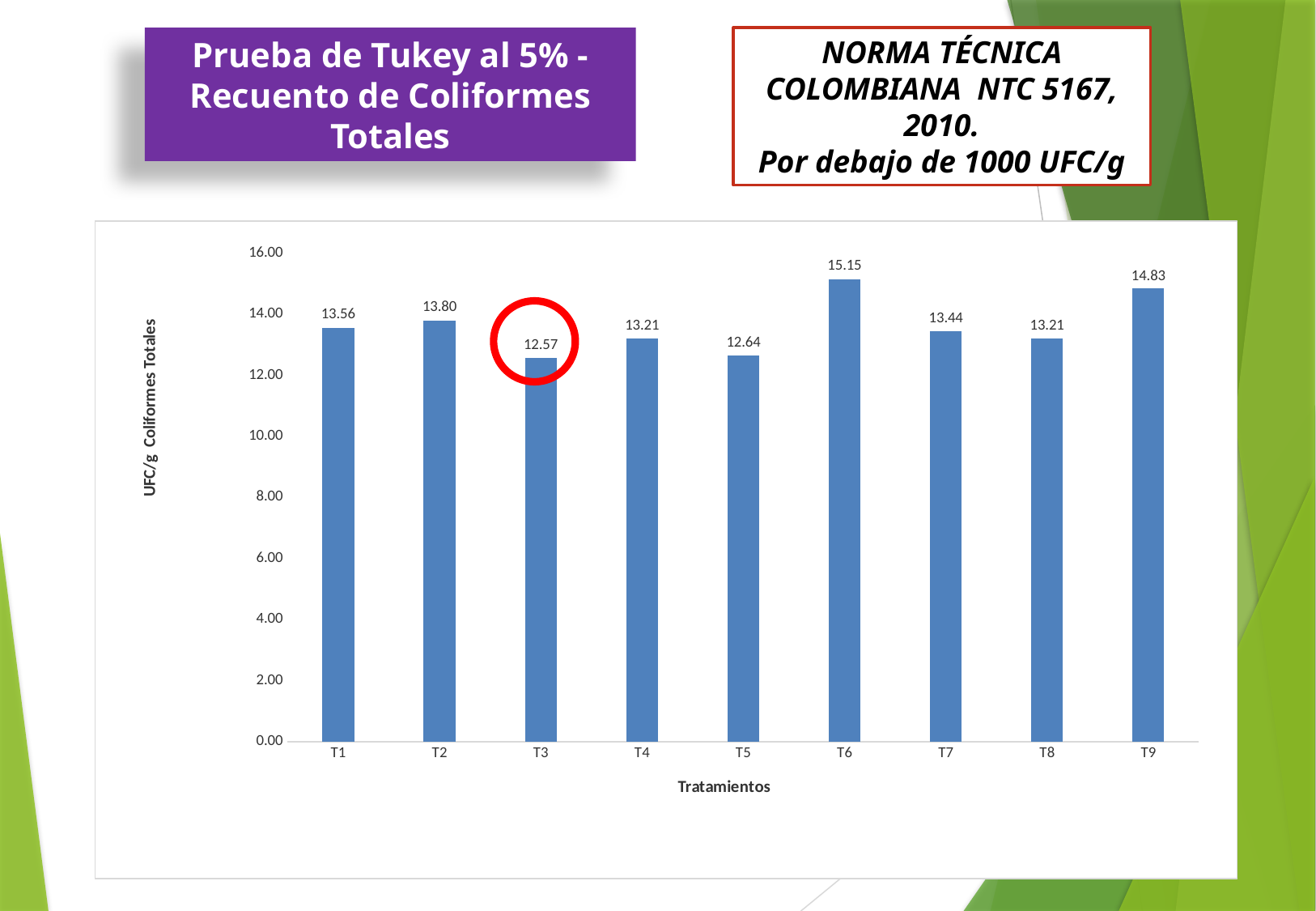
Which treatment has the highest value? T6 Is the value for T5 greater or less than 14.00? less Which bar is circled in red on the chart? T3 What is the label of the y axis? UFC/g Coliformes Totales What is the difference between the values for T6 and T3? 2.58 What is the value for T6? 15.15 Which treatment has the lowest value? T3 Which is larger, the value for T2 or the value for T7? T2 What is the value for T9? 14.83 How many treatments are shown on the x axis? 9 What kind of chart is shown? bar chart What is the value for T3? 12.57